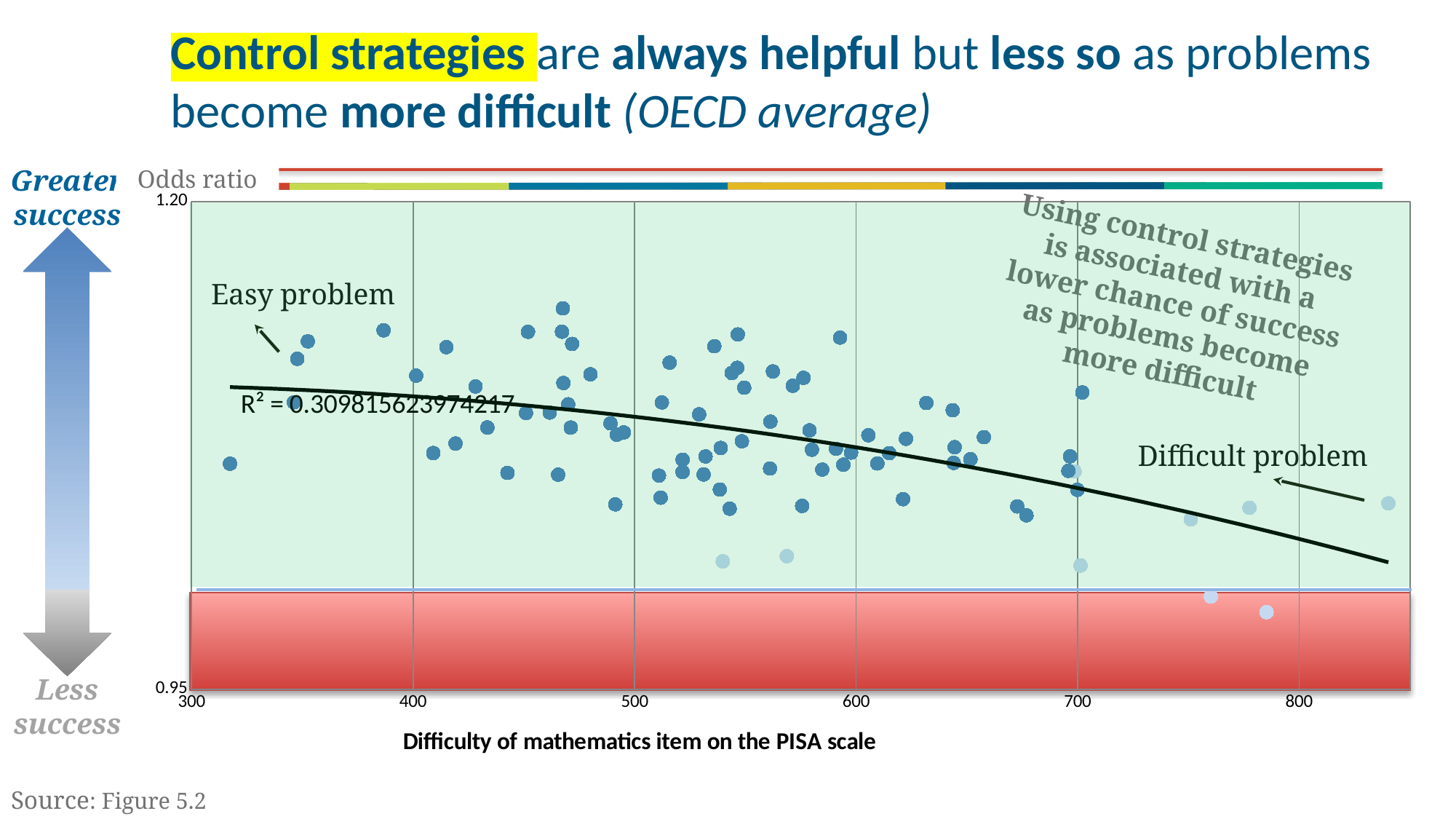
How many tick labels are shown on the x axis? 6 Is the trend line's odds ratio at a difficulty of 300 greater or less than 0.95? greater What is the title of the x axis of the chart? Difficulty of mathematics item on the PISA scale What is the lowest value labelled on the x axis? 300 What R² value is printed on the chart? R² = 0.309815623974217 What is the highest value labelled on the y axis? 1.20 Does the fitted trend line rise or fall as the difficulty of the mathematics item increases along the x axis? Fall Is the trend line's odds ratio at a difficulty of 800 greater or less than 1.20? less What quantity is plotted on the y axis of the chart? Odds ratio What kind of chart is shown on the slide? Scatter chart